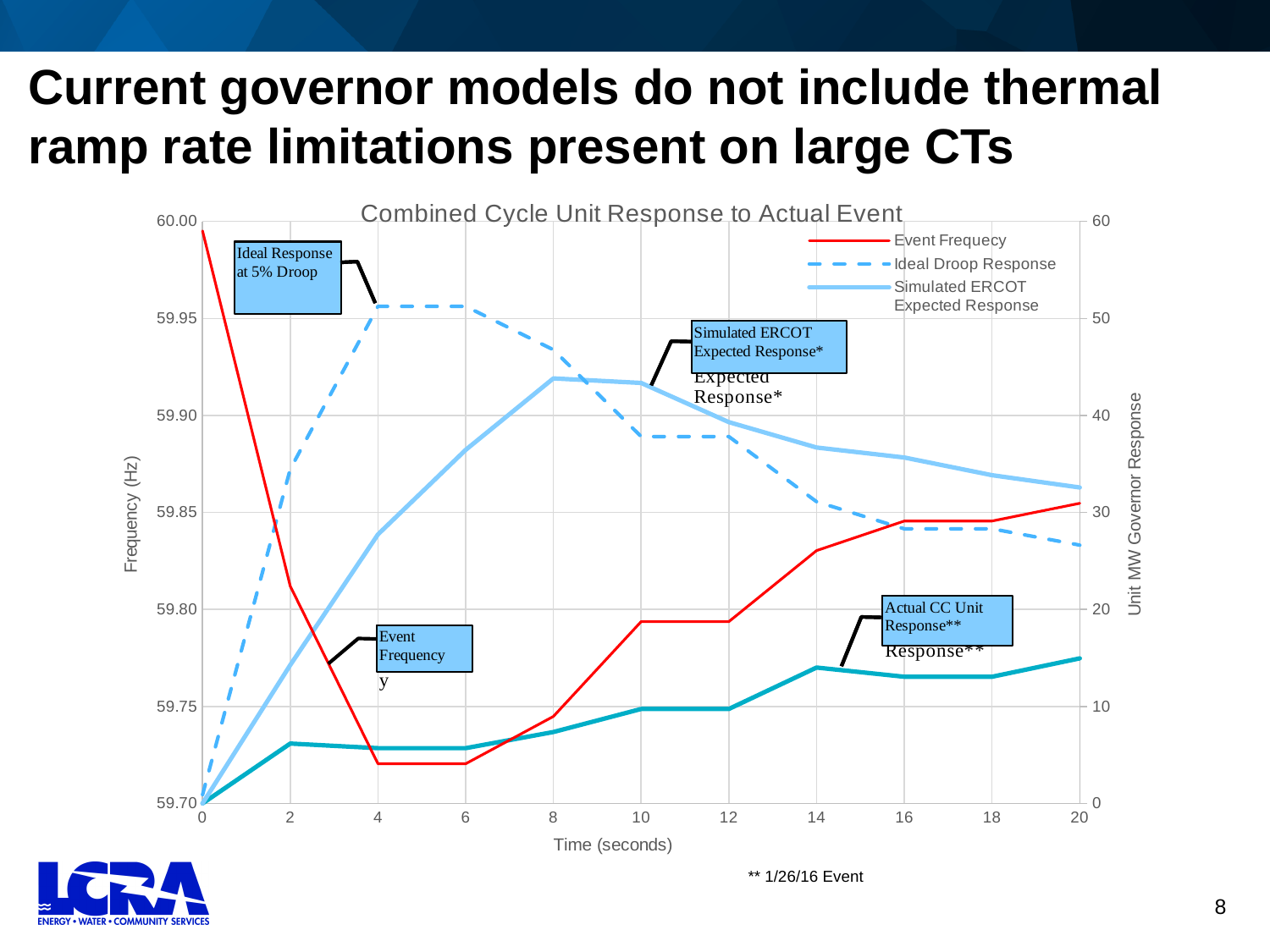
What kind of chart is shown on the slide? line chart How many series does the chart's legend list? 3 What is the title of the chart? Combined Cycle Unit Response to Actual Event At 10 seconds, which is higher: the Ideal Droop Response or the Simulated ERCOT Expected Response? Simulated ERCOT Expected Response What is the label of the right-hand vertical axis? Unit MW Governor Response Is the Actual CC Unit Response value at 20 seconds greater or less than 20? less Does the Event Frequency line rise or fall between 12 and 20 seconds? rise Does the Simulated ERCOT Expected Response line rise or fall between 8 and 20 seconds? fall Is the Simulated ERCOT Expected Response value at 8 seconds greater or less than 40? greater Is the Ideal Droop Response value at 10 seconds greater or less than 40? less Does the Event Frequency line rise or fall between 0 and 4 seconds? fall